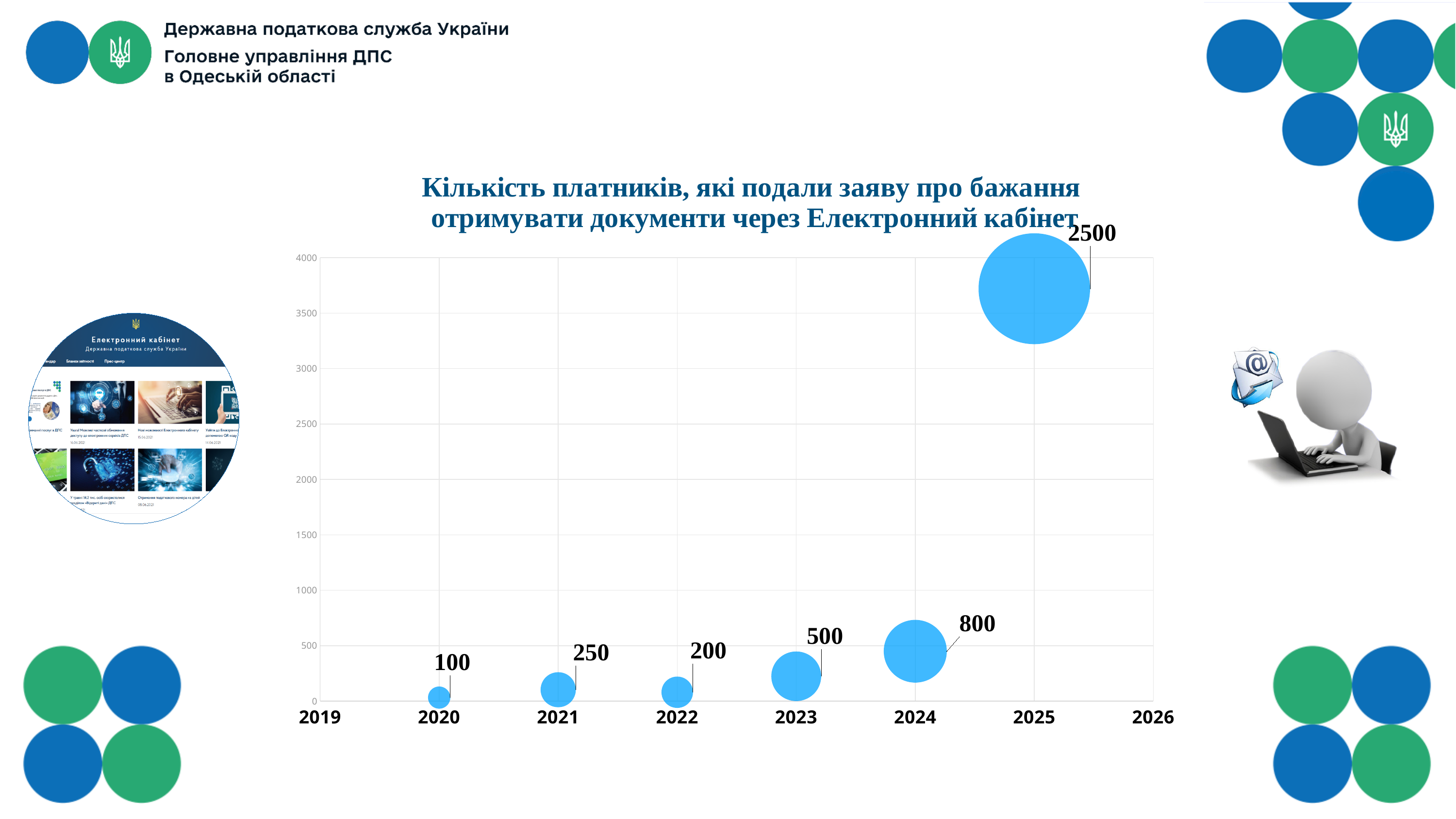
What is the value shown for 2024? 800 What is the value shown for 2020? 100 Which year has the highest value? 2025 What is the value shown for 2022? 200 What is the difference between the values for 2024 and 2023? 300 What kind of chart is shown on the slide? Bubble chart What is the title of the chart? Кількість платників, які подали заяву про бажання отримувати документи через Електронний кабінет Which is larger, the value for 2021 or the value for 2022? 2021 Which year has the lowest value? 2020 What is the value shown for 2025? 2500 Do the values generally rise or fall from 2020 to 2025? Rise How many data points are plotted on the chart? 6